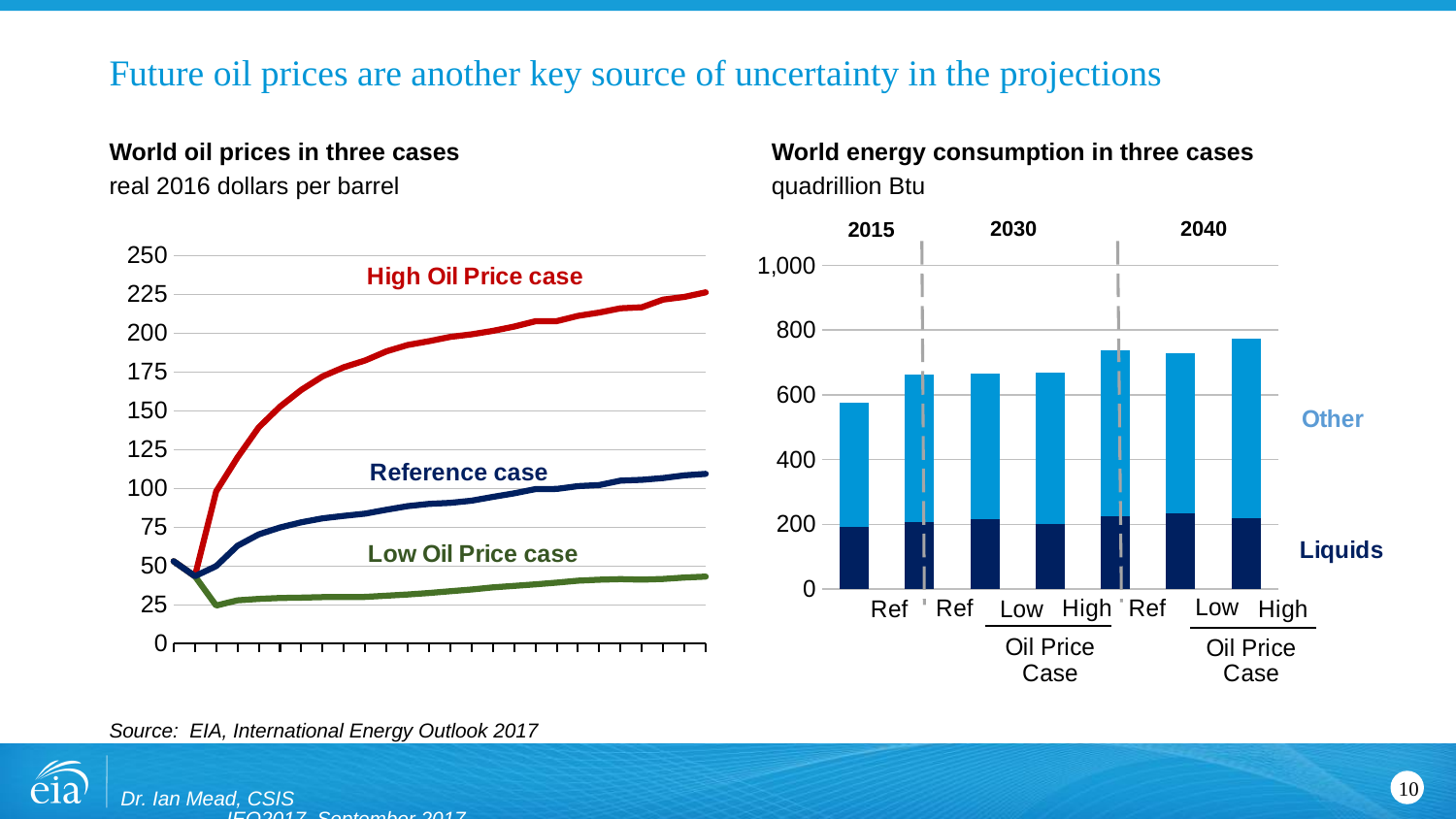
In the left chart, 'World oil prices in three cases', does the High Oil Price case rise or fall over the projection period after its initial dip? rise In the left chart, 'World oil prices in three cases', which case has the highest price at the end of the projection? High Oil Price case What kind of chart is the right chart, 'World energy consumption in three cases'? stacked bar chart In the left chart, 'World oil prices in three cases', how many cases (series) are plotted? 3 In the right chart, 'World energy consumption in three cases', which bar is the tallest? 2040 High Oil Price Case In the right chart, 'World energy consumption in three cases', is the total for 2015 Ref greater or less than 600? less In the left chart, 'World oil prices in three cases', is the final value of the Low Oil Price case greater or less than 50? less In the right chart, 'World energy consumption in three cases', how many bars are shown? 7 What kind of chart is the left chart, 'World oil prices in three cases'? line chart In the left chart, 'World oil prices in three cases', is the final value of the High Oil Price case greater or less than 200? greater In the right chart, 'World energy consumption in three cases', what are the two components of each stacked bar? Other and Liquids In the left chart, 'World oil prices in three cases', which case has the lowest price at the end of the projection? Low Oil Price case